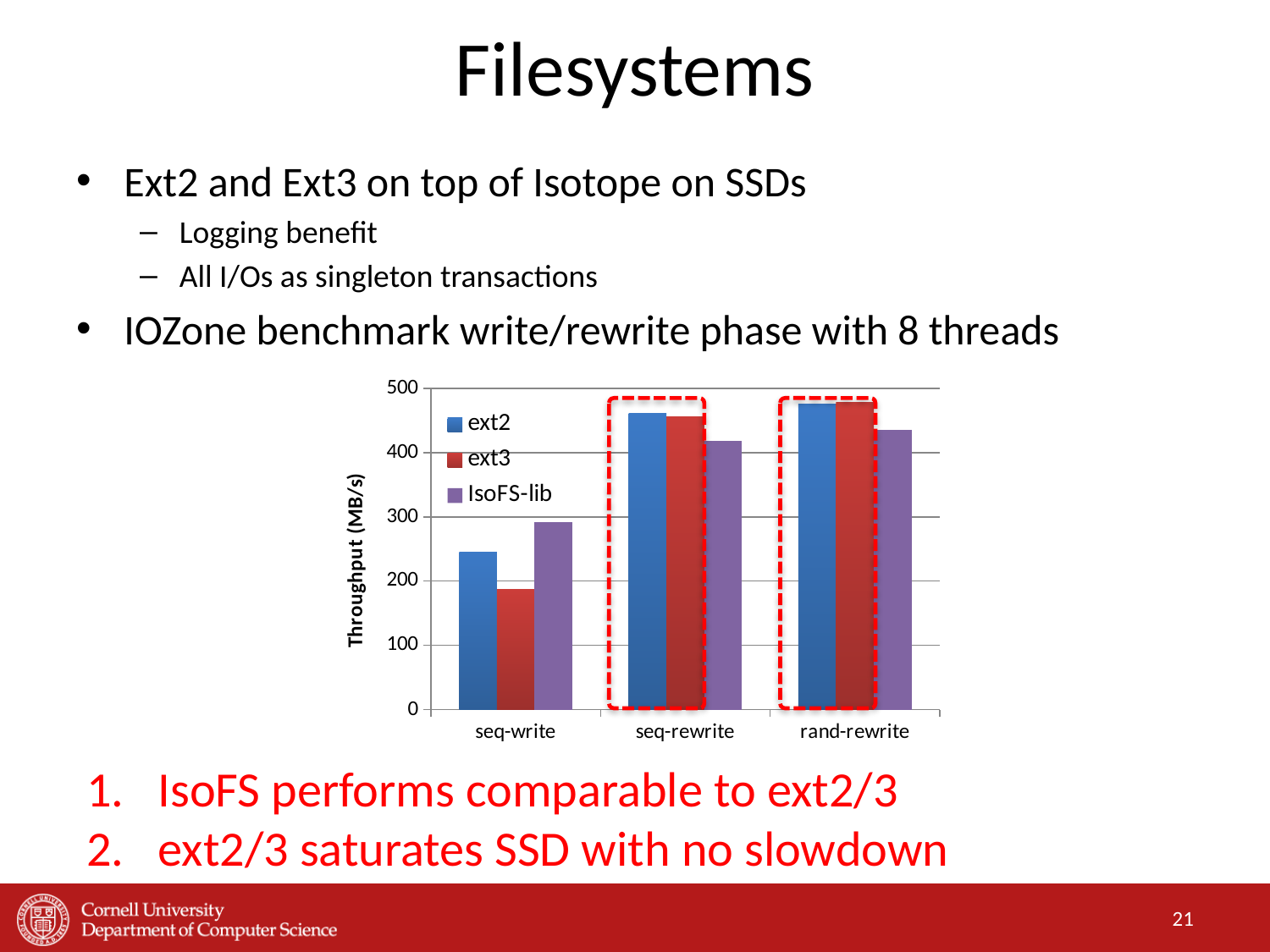
What is the label of the y axis of the chart? Throughput (MB/s) Which series is shown in purple in the chart? IsoFS-lib What kind of chart is shown on the slide? bar chart Is the ext2 value for seq-rewrite greater or less than 400? greater For seq-write, which is larger: the ext2 value or the ext3 value? ext2 How many categories are shown on the x axis of the chart? 3 Is the ext3 value for seq-write greater or less than 200? less Which series has the highest value for seq-write? IsoFS-lib Which series has the lowest value for seq-rewrite? IsoFS-lib How many series does the chart legend list? 3 Is the IsoFS-lib value for rand-rewrite greater or less than 400? greater